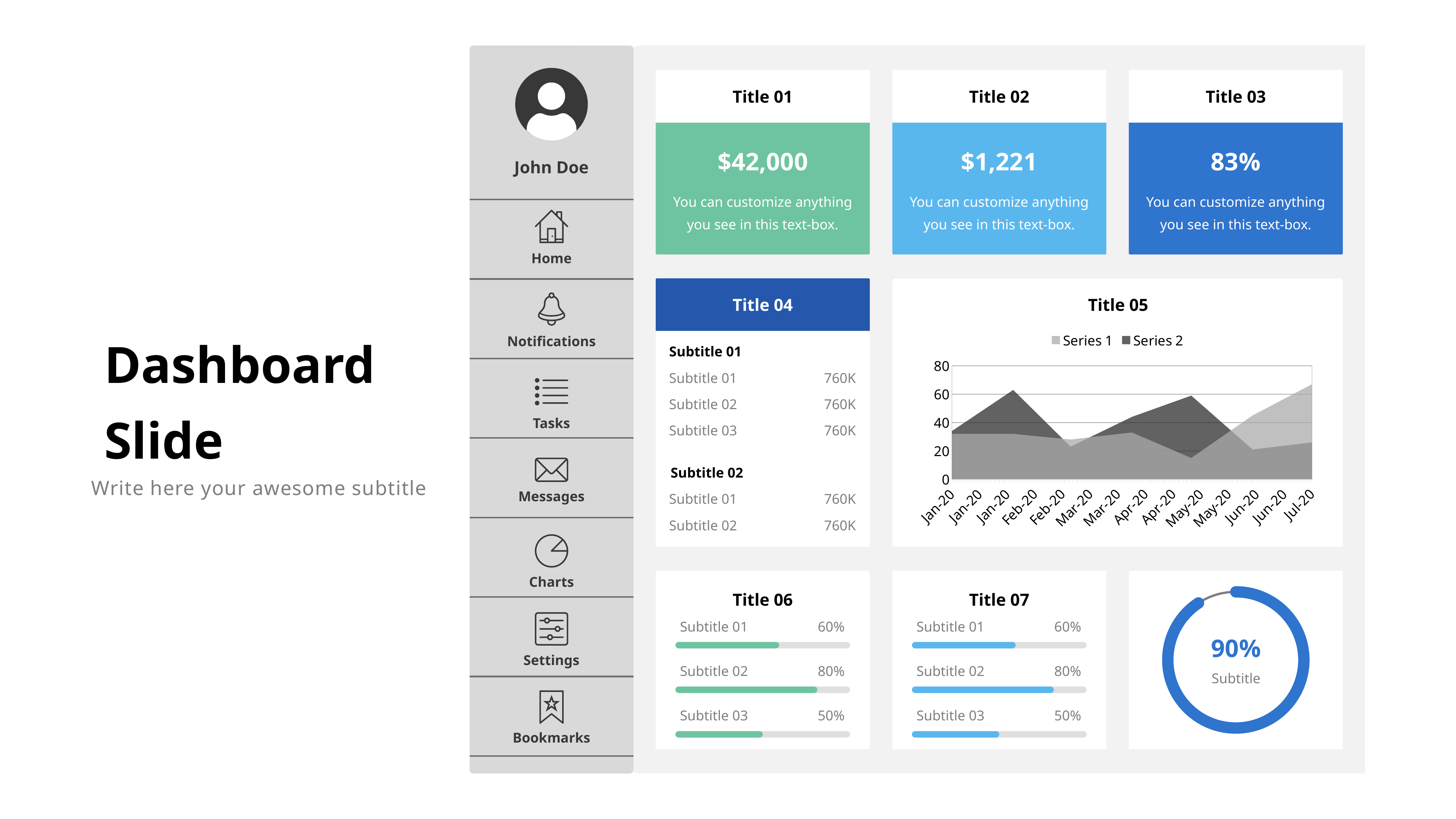
In the Title 05 chart, which series has the larger value at Jul-20, Series 1 or Series 2? Series 1 How many points are plotted along the x axis of the Title 05 chart? 7 In the Title 05 chart, is the value of Series 1 at the first Jan-20 point greater or less than 40? less What are the legend entries of the Title 05 chart? Series 1, Series 2 In the Title 06 progress bars, what is the value for Subtitle 02? 80% In the Title 07 progress bars, which subtitle has the lowest value? Subtitle 03 What kind of chart is shown under Title 05? area chart In the Title 05 chart, is the value of Series 1 at Jul-20 greater or less than 40? greater How many series does the legend of the Title 05 chart list? 2 What is the highest value shown on the y axis of the Title 05 chart? 80